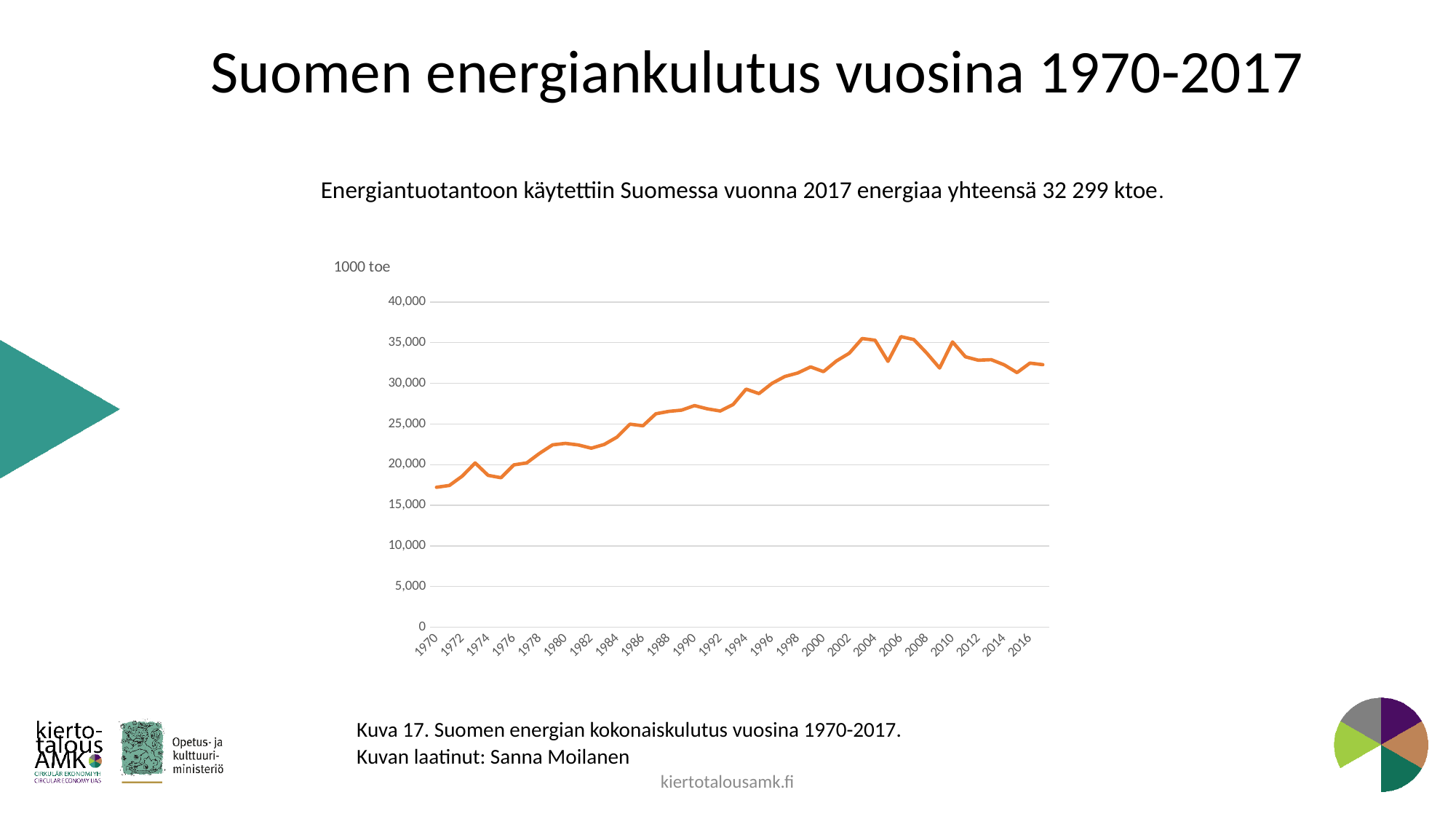
How many lines are plotted on the chart? 1 What unit is shown above the vertical axis of the chart? 1000 toe Is the value for 1970 greater or less than 20,000? less Is the value for 1980 greater or less than 20,000? greater Is the value for 2000 greater or less than 30,000? greater What kind of chart is shown on the slide? line chart Which year has the larger value, 1980 or 1990? 1990 Overall, do the values rise or fall from 1970 to 2017? rise Which year has the larger value, 2010 or 2016? 2010